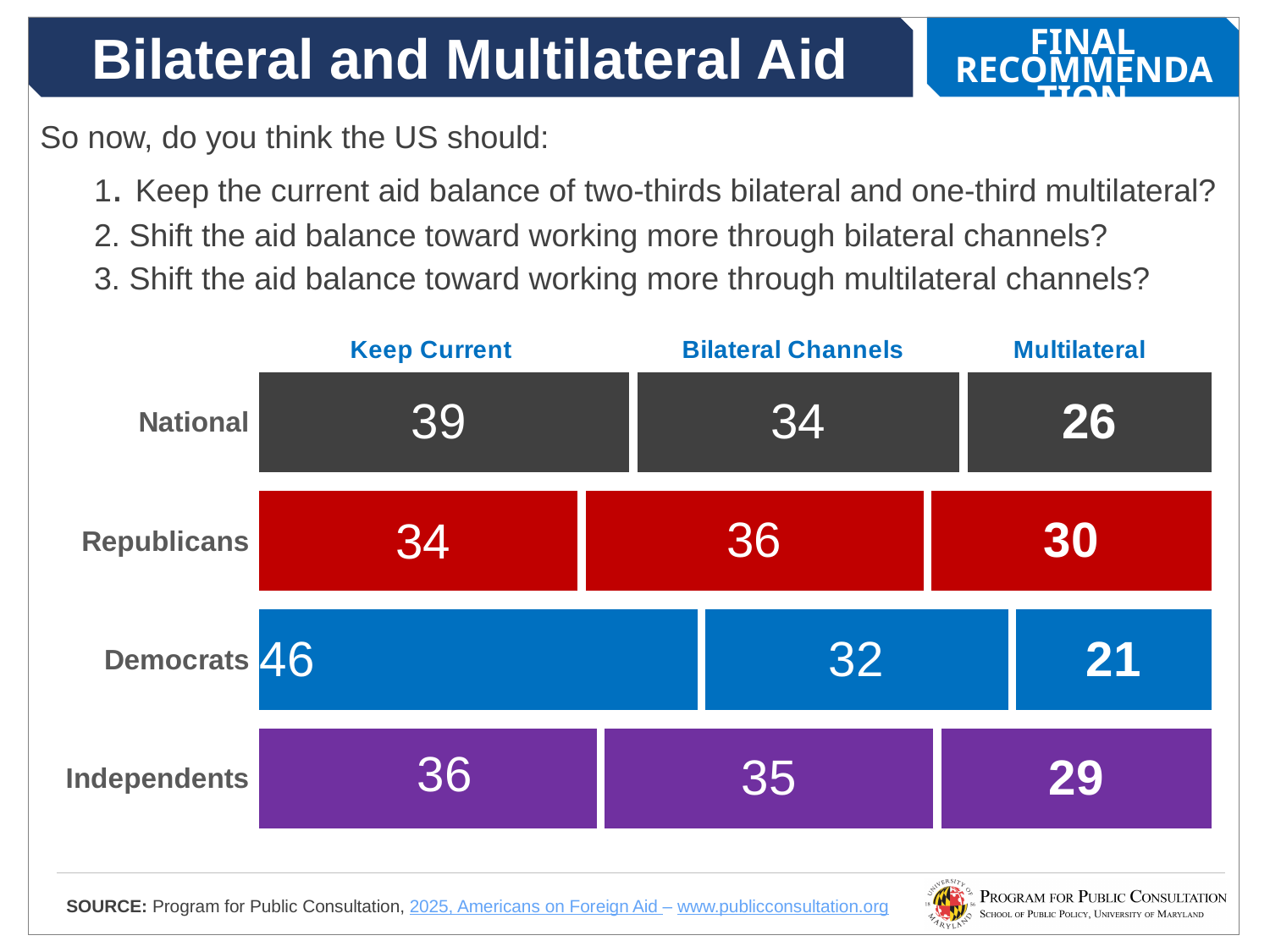
Which group has the highest value for Keep Current? Democrats How many response categories are shown across the top of the chart? 3 What is the Democrats value for Multilateral? 21 What is the Republicans value for Bilateral Channels? 36 Which is larger for Republicans: Keep Current or Bilateral Channels? Bilateral Channels What is the difference between the Democrats' Keep Current value and their Multilateral value? 25 Which group has the lowest value for Multilateral? Democrats What is the total of the three values in the National bar? 99 What is the National value for Keep Current? 39 What kind of chart is shown on the slide? Stacked bar chart How many groups (rows) are shown in the chart? 4 What is the Independents value for Keep Current? 36